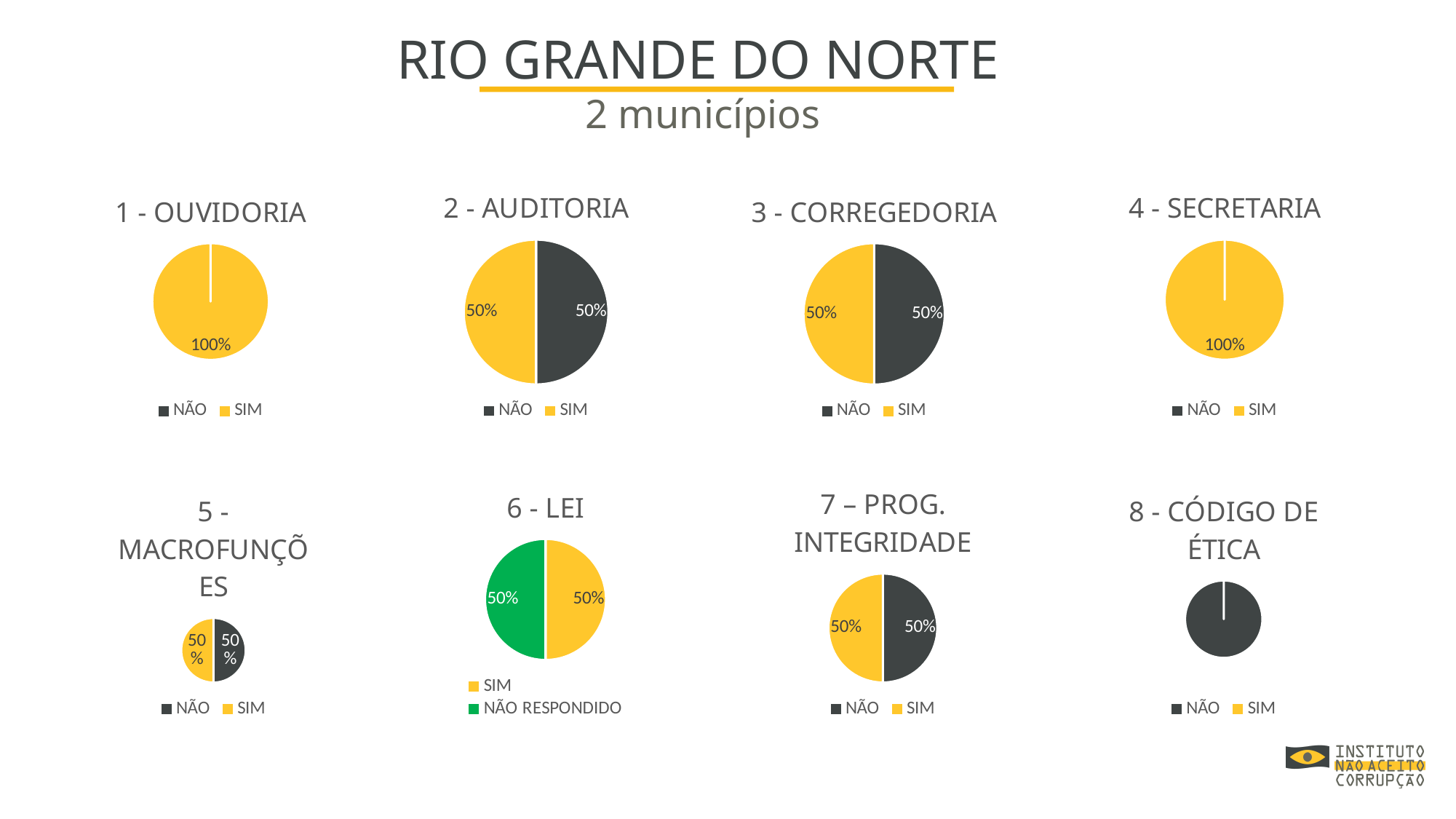
How many entries does the legend of the "6 - LEI" chart list? 2 In the "4 - SECRETARIA" chart, what share is labelled on the SIM slice? 100% In the "7 – PROG. INTEGRIDADE" chart, what share is labelled on the SIM slice? 50% What kind of chart is the "1 - OUVIDORIA" chart? pie chart In the "5 - MACROFUNÇÕES" chart, what share is labelled on the NÃO slice? 50% How many slices does the "3 - CORREGEDORIA" pie chart have? 2 In the "6 - LEI" chart, what share is labelled on the NÃO RESPONDIDO slice? 50% In the "2 - AUDITORIA" chart, what share is labelled on the NÃO slice? 50% In the "1 - OUVIDORIA" chart, what share is labelled on the SIM slice? 100% How many pie charts are shown on the slide? 8 What are the legend entries of the "6 - LEI" chart? SIM, NÃO RESPONDIDO In the "8 - CÓDIGO DE ÉTICA" chart, which legend entry's colour fills the entire pie? NÃO